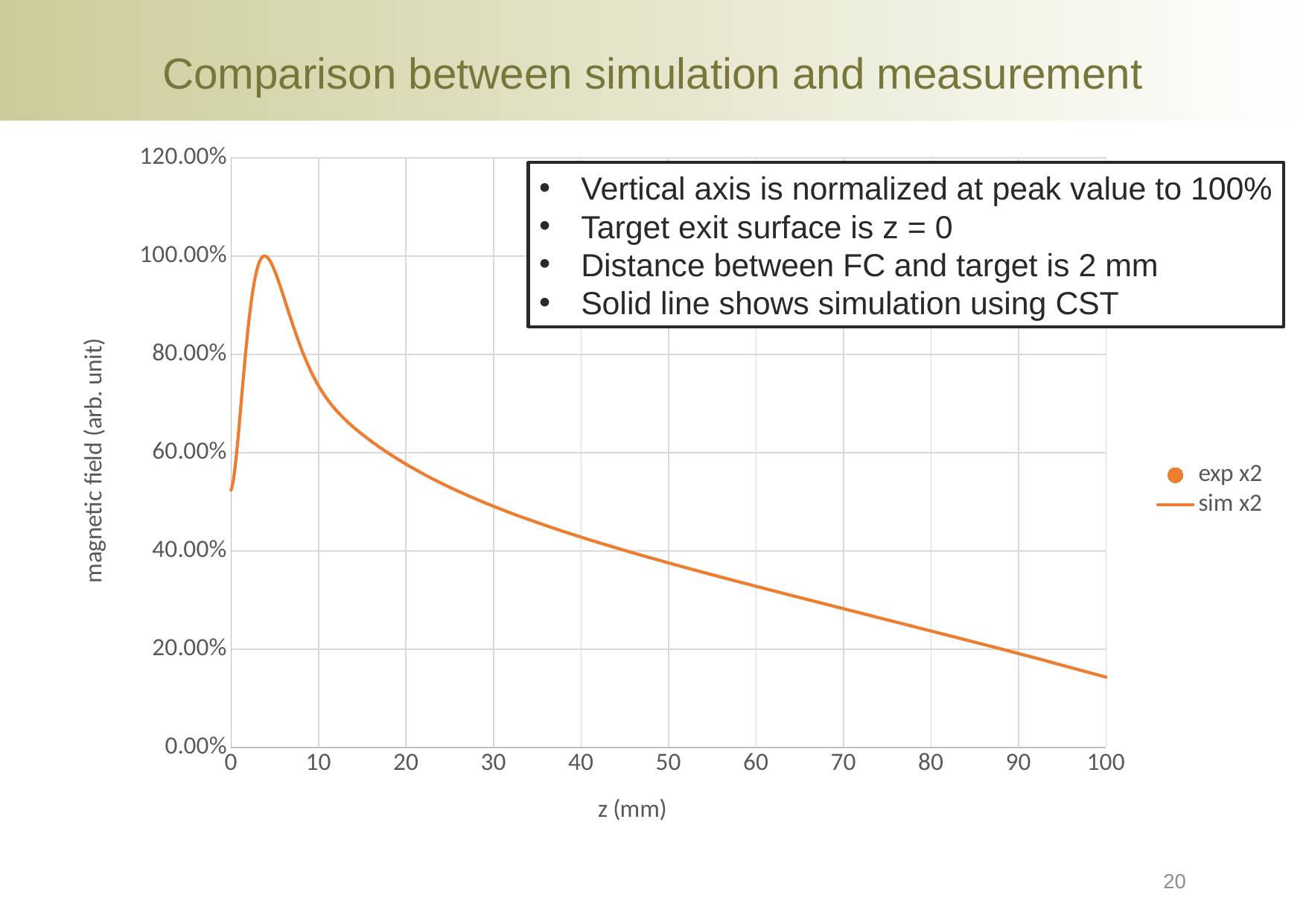
What is the highest tick value shown on the vertical axis? 120.00% Is the value of the sim x2 curve at z = 100 greater or less than 20.00%? less Is the value of the sim x2 curve at z = 60 greater or less than 40.00%? less What kind of chart is shown on the slide? line chart What is the peak value reached by the sim x2 curve? 100.00% Is the value of the sim x2 curve at z = 30 greater or less than 40.00%? greater What is the label of the horizontal axis? z (mm) What are the two entries in the chart legend? exp x2 and sim x2 Which is larger for the sim x2 curve: the value at z = 20 or the value at z = 80? z = 20 After its peak, does the sim x2 curve rise or fall as z increases toward 100? fall How many series does the legend list? 2